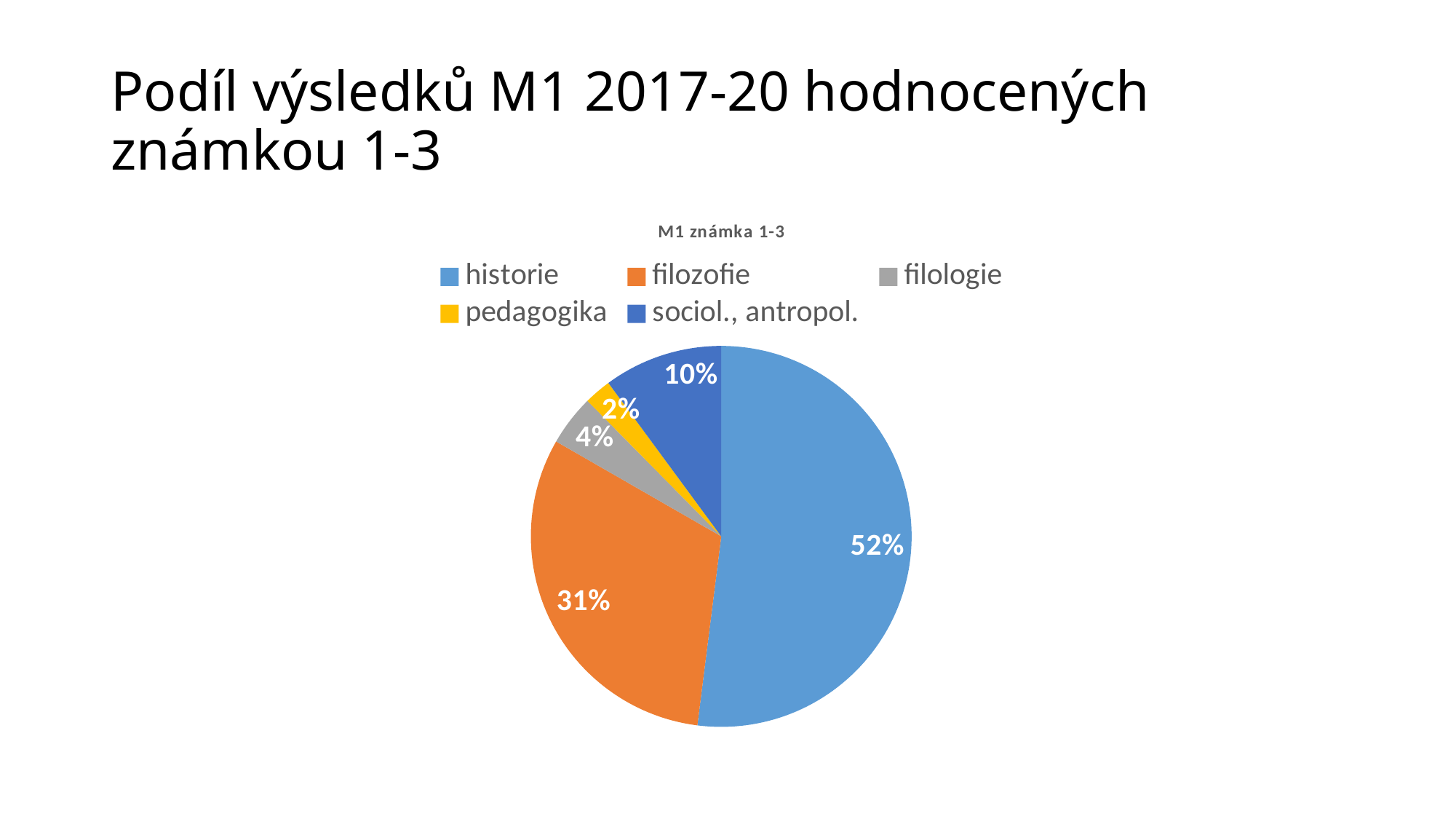
What is the title of the chart? M1 známka 1-3 What share of the pie does historie have? 52% What is the difference in percentage points between historie and filozofie? 21 What share of the pie does filozofie have? 31% What share of the pie does sociol., antropol. have? 10% What kind of chart is shown on the slide? pie chart Which category has the smallest slice of the pie? pedagogika Which category has the largest slice of the pie? historie How many categories does the legend list? 5 Which is larger, the share for sociol., antropol. or the share for filologie? sociol., antropol.